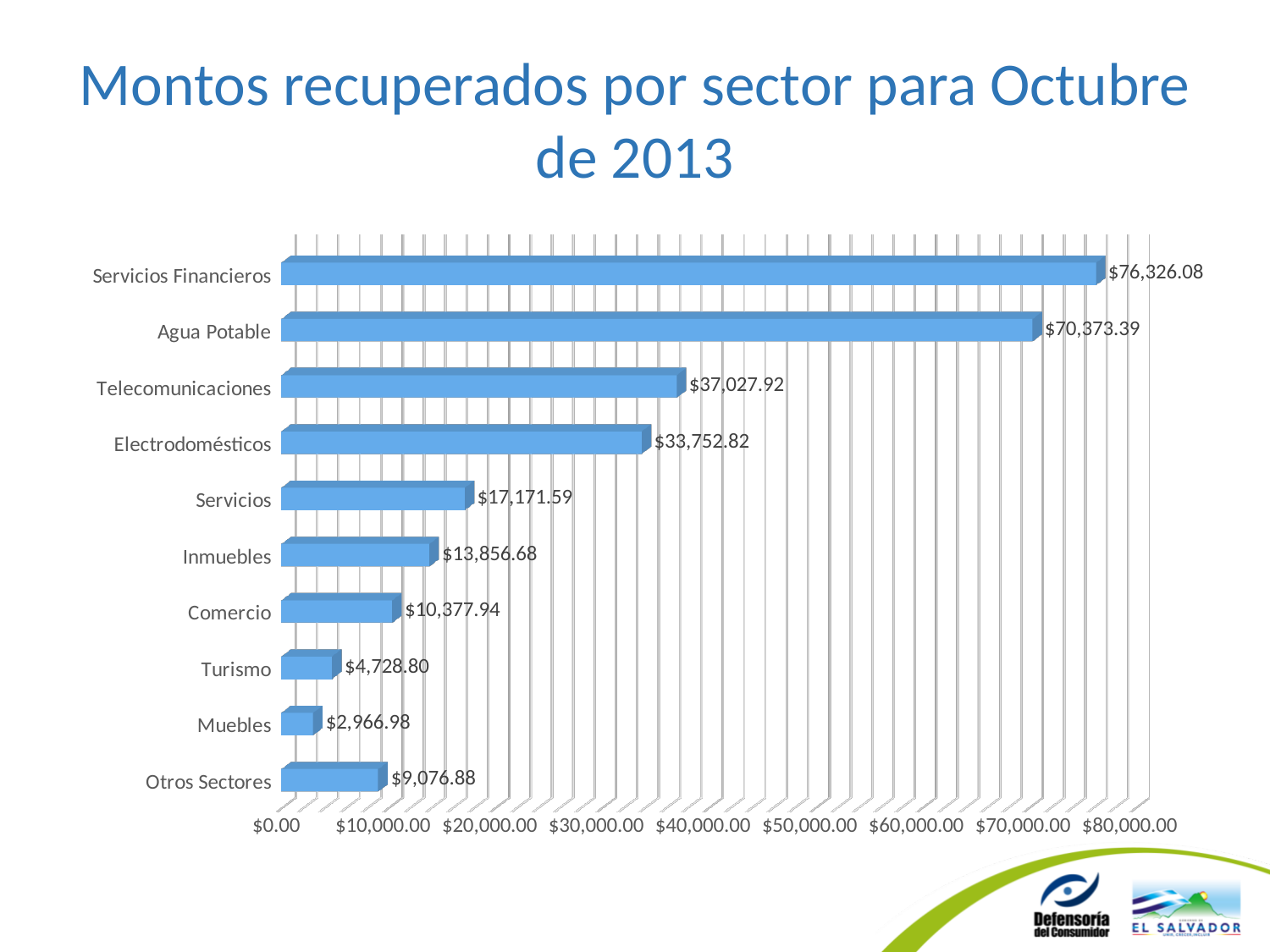
What is the value for Otros Sectores? $9,076.88 How many sectors are shown in the chart? 10 What is the value for Servicios Financieros? $76,326.08 What is the difference between the values for Telecomunicaciones and Electrodomésticos? $3,275.10 What is the difference between the values for Servicios Financieros and Agua Potable? $5,952.69 What kind of chart is shown on the slide? Bar chart Which sector has the highest recovered amount? Servicios Financieros What is the value for Telecomunicaciones? $37,027.92 What is the value for Turismo? $4,728.80 Which sector has the lowest recovered amount? Muebles Which is larger, the value for Comercio or the value for Otros Sectores? Comercio What is the value for Agua Potable? $70,373.39